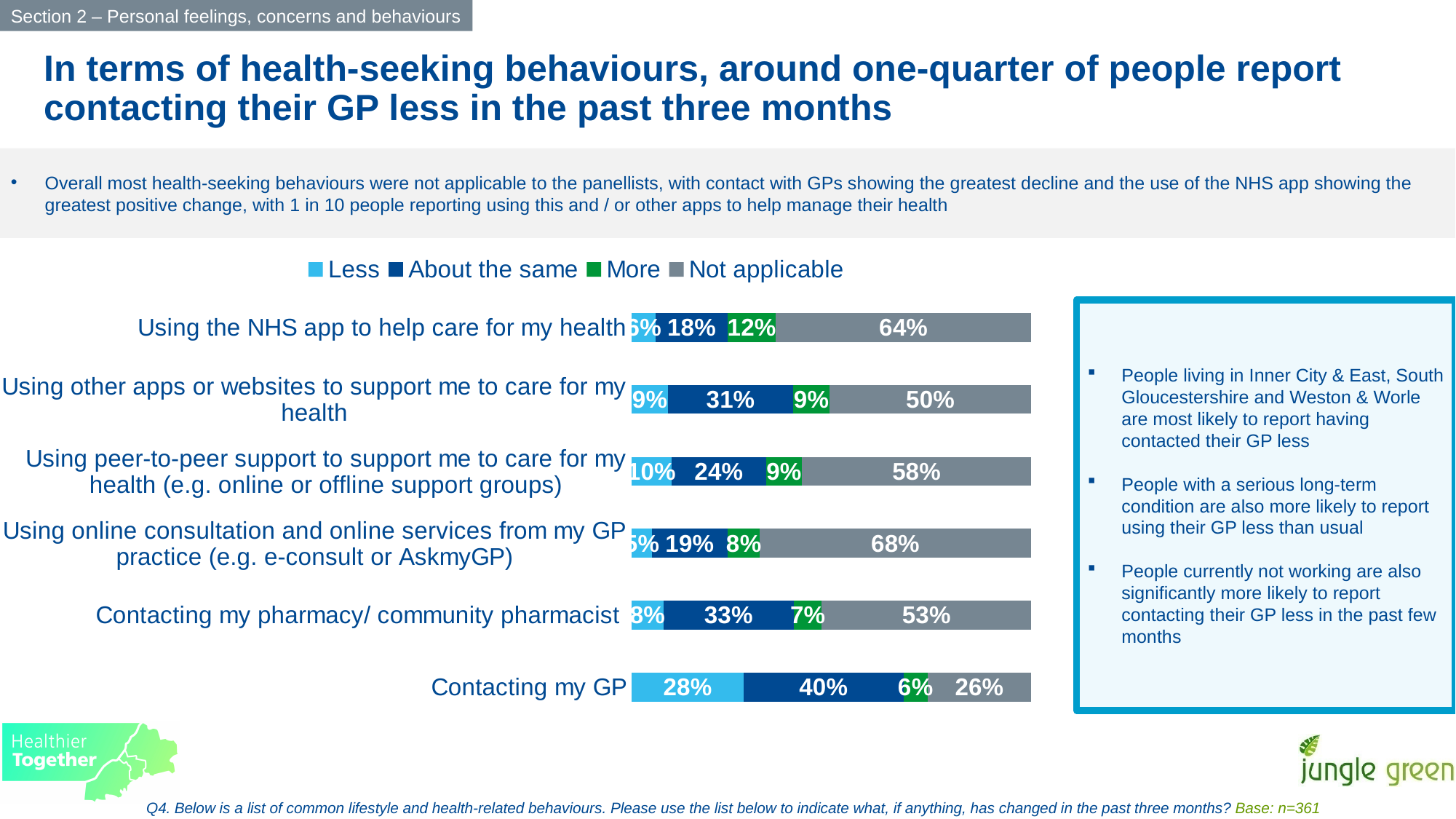
How many behaviours (categories) are plotted in the chart? 6 What percentage of people report contacting their GP less? 28% What kind of chart is shown on the slide? Stacked bar chart What is the 'About the same' value for 'Contacting my pharmacy/ community pharmacist'? 33% Which is larger: the 'Not applicable' value for 'Using peer-to-peer support' or for 'Using other apps or websites'? Using peer-to-peer support Which behaviour has the highest 'Not applicable' value? Using online consultation and online services from my GP practice (e.g. e-consult or AskmyGP) What is the 'More' value for 'Using the NHS app to help care for my health'? 12% What is the difference between the 'About the same' values for 'Contacting my GP' and 'Using the NHS app to help care for my health'? 22 percentage points Which behaviour has the lowest 'Not applicable' value? Contacting my GP Which legend entry is shown in green? More What is the 'Not applicable' value for 'Using online consultation and online services from my GP practice'? 68% How many series does the legend list? 4